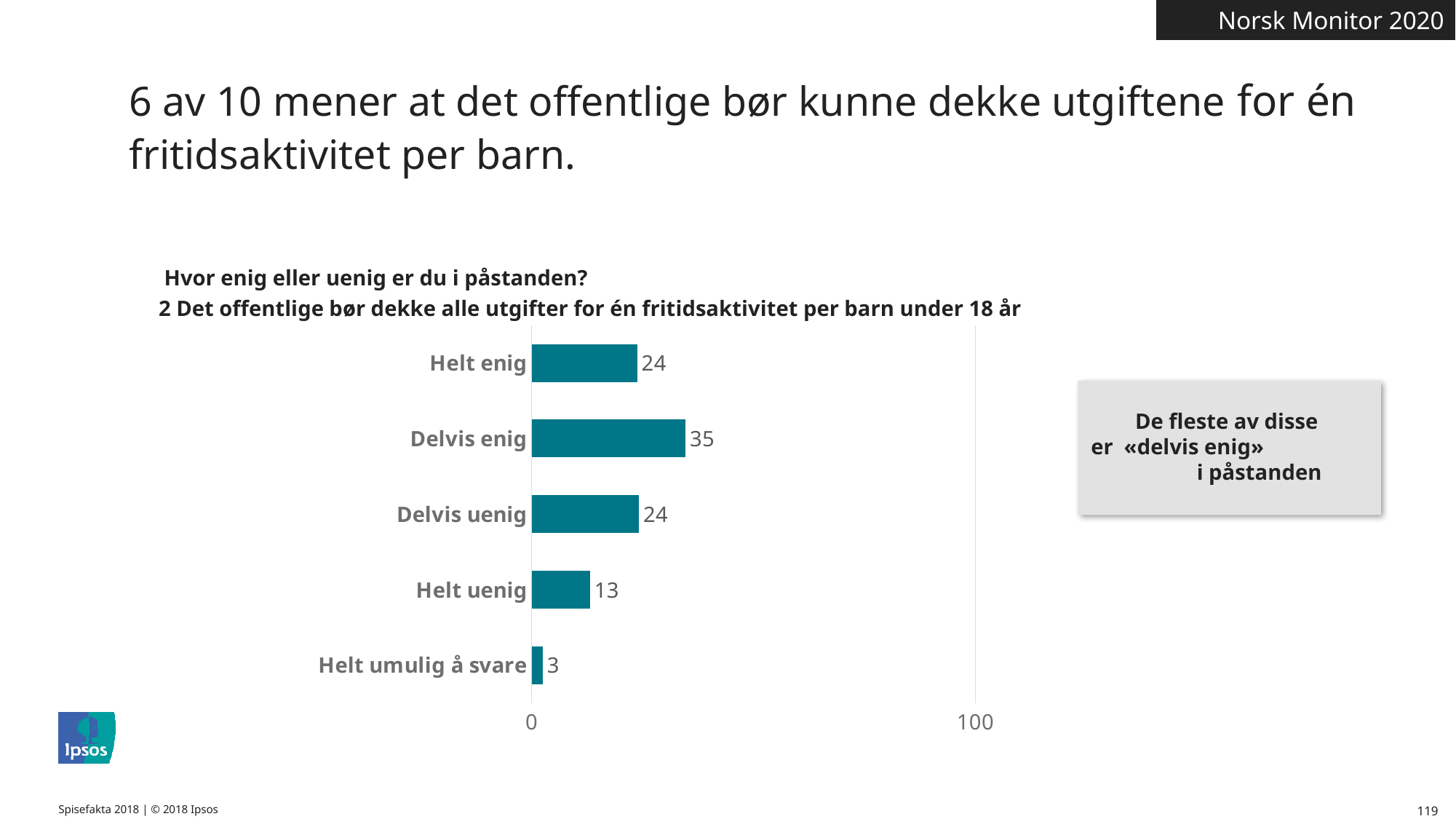
What kind of chart is shown on the slide? Bar chart Which category has the lowest value? Helt umulig å svare What is the value for "Delvis enig"? 35 What colour are the bars in the chart? Teal What is the value for "Helt uenig"? 13 Which category has the highest value? Delvis enig What is the difference between the values for "Delvis enig" and "Helt enig"? 11 What is the difference between the values for "Helt uenig" and "Helt umulig å svare"? 10 Which is larger, the value for "Delvis uenig" or the value for "Helt uenig"? Delvis uenig What is the maximum value shown on the chart's axis? 100 How many categories are shown in the chart? 5 What is the value for "Helt umulig å svare"? 3